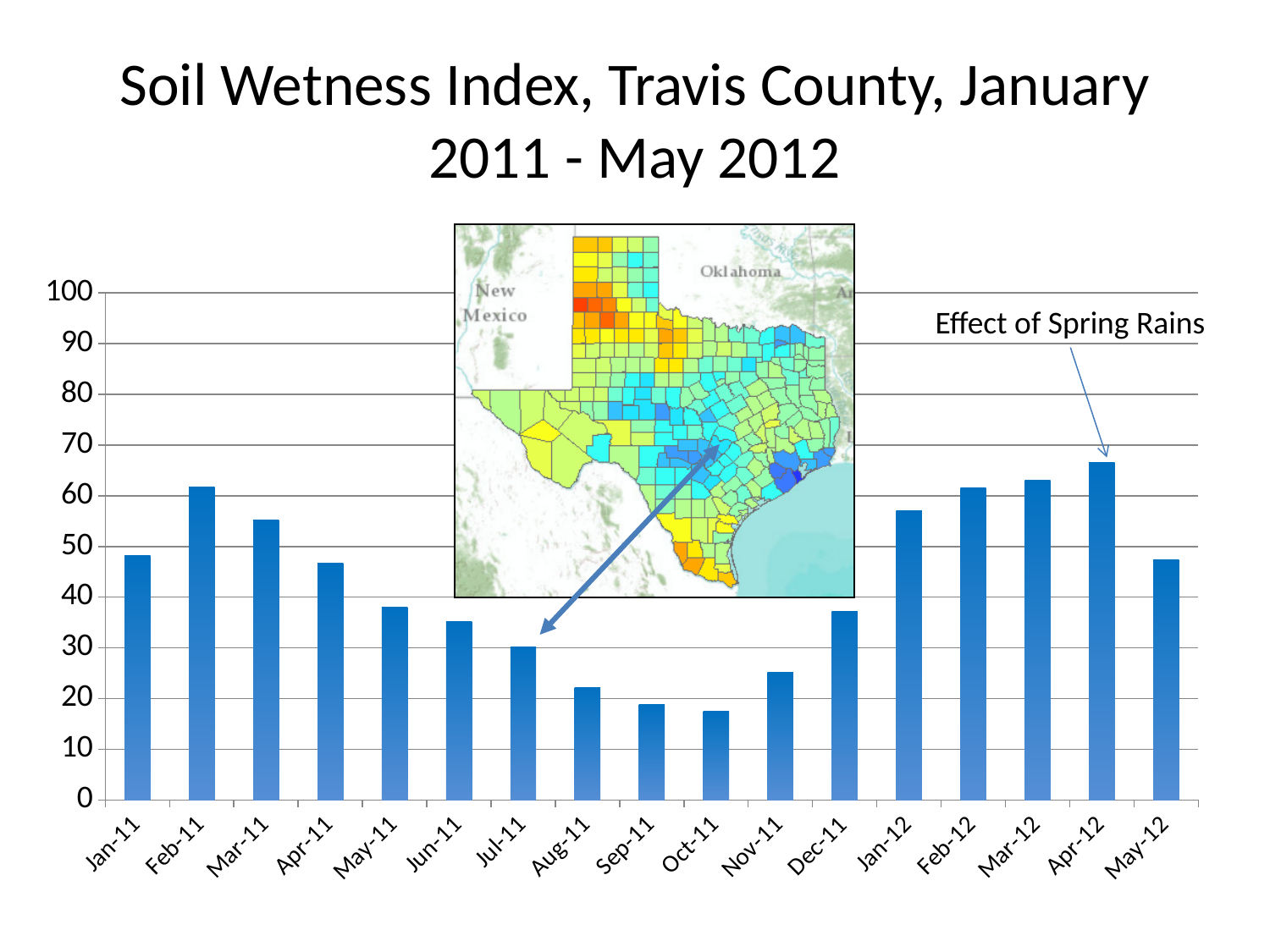
Which is larger, the value for Jan-11 or the value for Feb-11? Feb-11 How many months (bars) are plotted on the chart? 17 Which month has the highest soil wetness index value? Apr-12 Is the value for Jul-11 greater or less than 40? less Is the value for Dec-11 greater or less than 30? greater Which is larger, the value for Apr-12 or the value for May-12? Apr-12 Is the value for Apr-12 greater or less than 60? greater Do the values rise or fall from Jan-11 to Oct-11? fall What does the annotation text on the chart say? Effect of Spring Rains What kind of chart is shown on the slide? bar chart